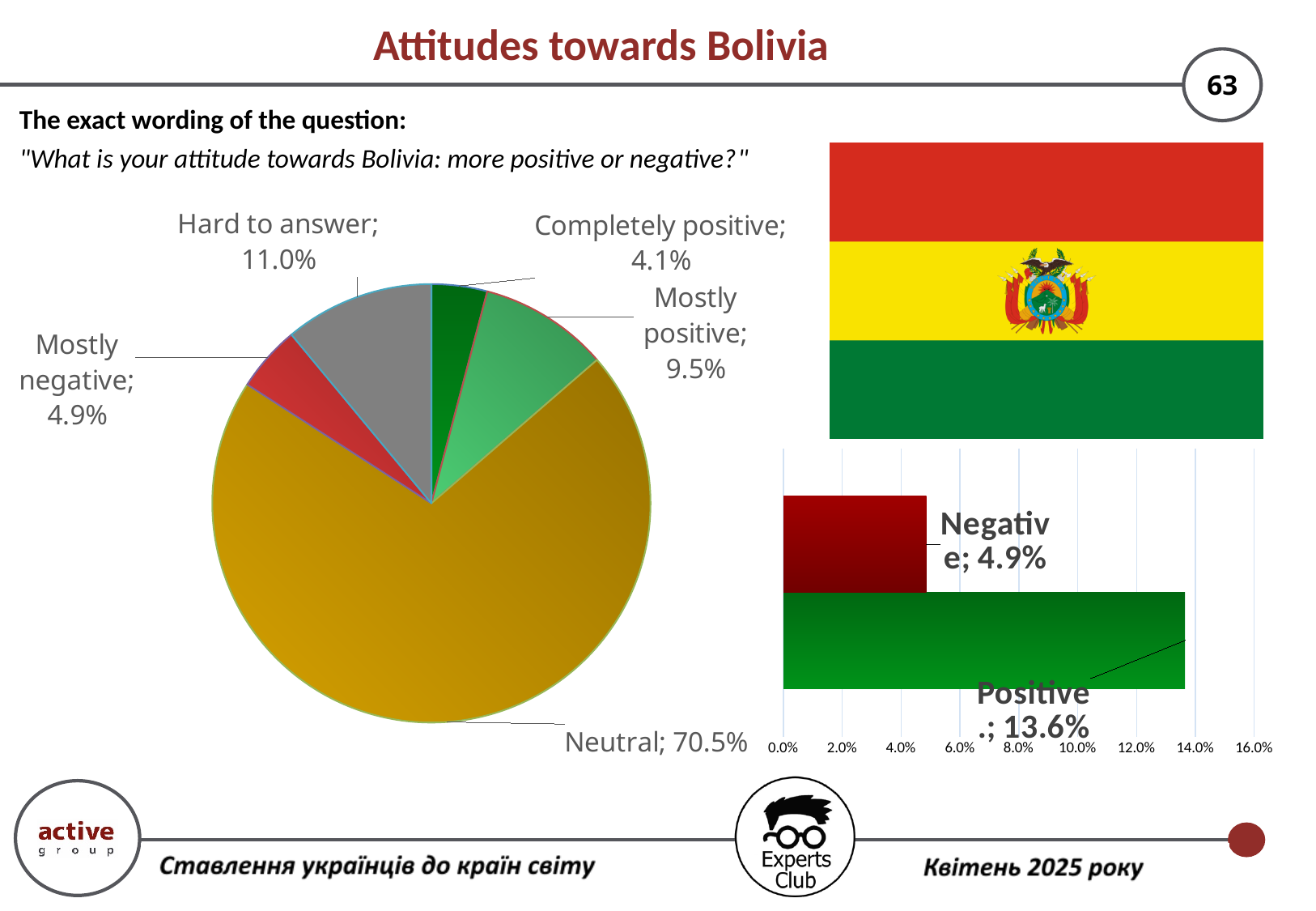
In the pie chart, what is the value for Completely positive? 4.1% In the pie chart, which category has the smallest slice? Completely positive In the bar chart on the right, what is the value for Positive? 13.6% In the pie chart, which category has the largest slice? Neutral In the pie chart, what is the value for Mostly positive? 9.5% In the bar chart on the right, what is the difference between Positive and Negative? 8.7% In the pie chart, what is the value for Hard to answer? 11.0% What type of chart is shown on the right side of the slide below the flag? Bar chart In the pie chart, how many categories are shown? 5 In the pie chart, what share of respondents answered Neutral? 70.5% In the pie chart, which is larger: Hard to answer or Mostly positive? Hard to answer In the pie chart, what is the difference between Mostly positive and Mostly negative? 4.6%